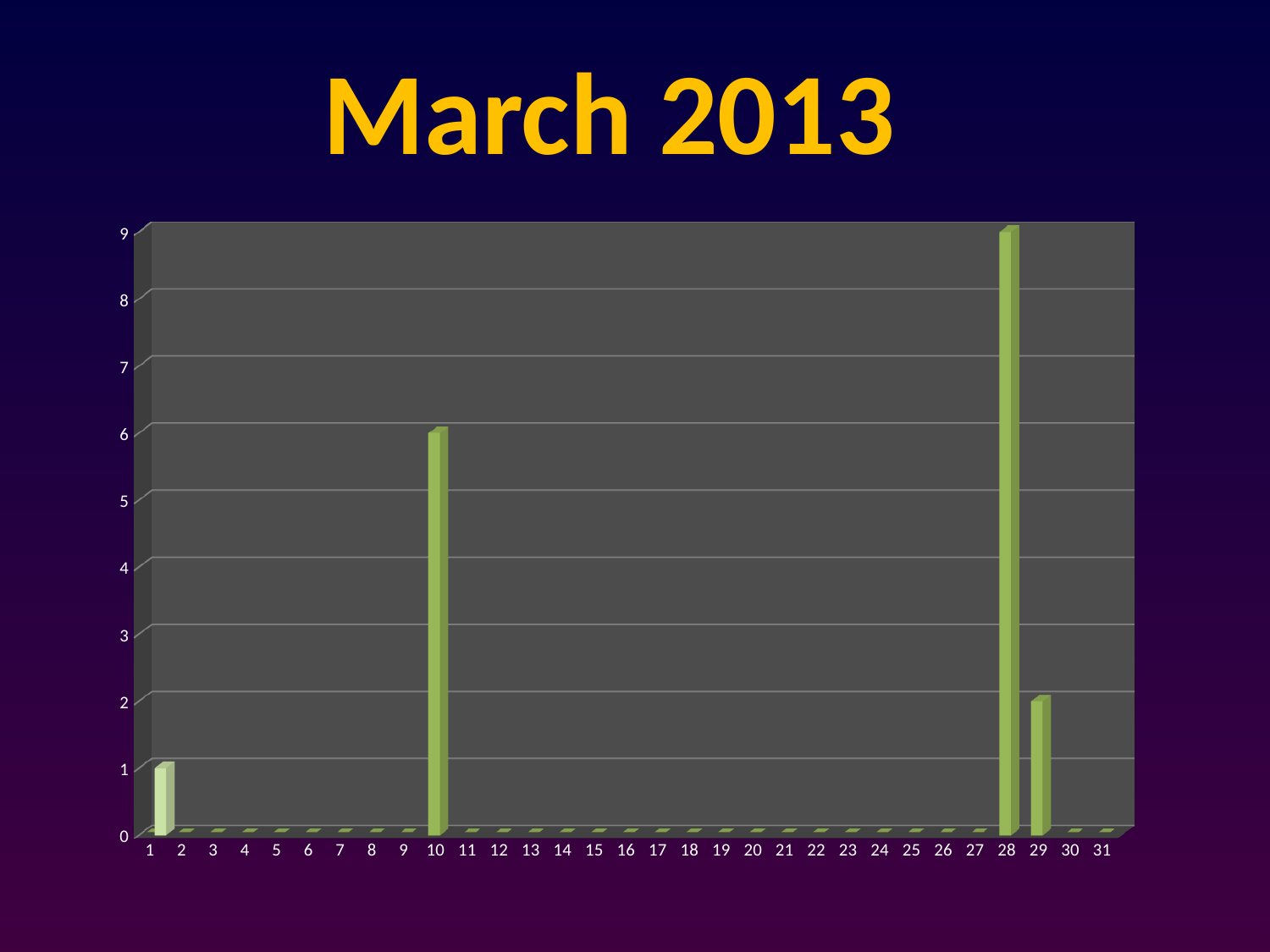
What kind of chart is shown on the slide? bar chart What is the value for day 1? 1 Which is larger, the value for day 10 or the value for day 29? day 10 What is the value for day 10? 6 What is the value for day 28? 9 How many categories are shown along the x axis? 31 How many days have a bar with a value above 0? 4 What is the difference between the values for day 28 and day 10? 3 Is the value for day 10 greater or less than 5? greater What is the title of the chart? March 2013 What is the value for day 29? 2 Which day has the highest value? 28